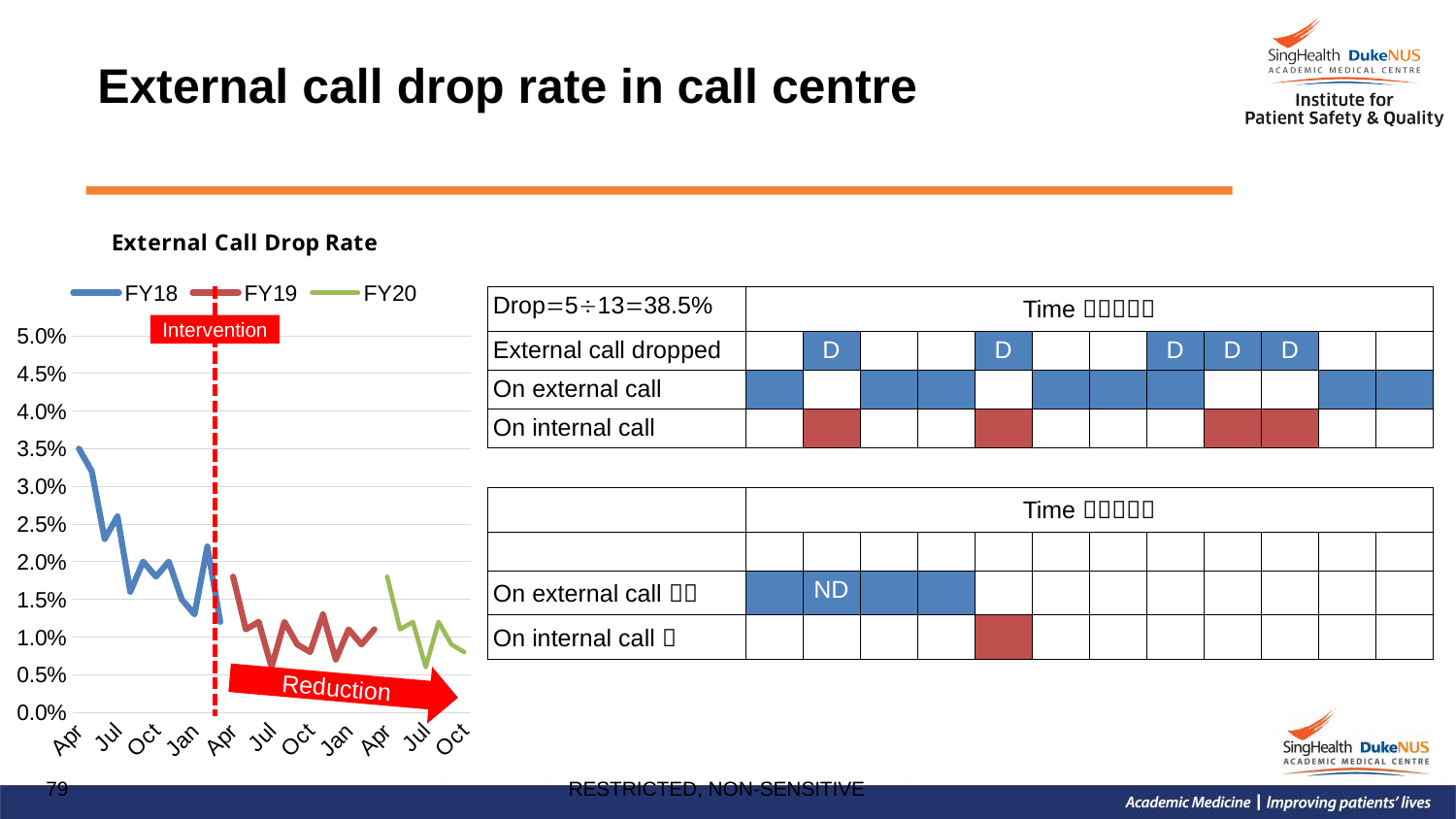
Is the FY20 value at Oct greater or less than 1.0%? less Does the FY18 line rise or fall from Apr to the end of the fiscal year? Fall What is the title of the chart on the slide? External Call Drop Rate Are the FY19 values greater or less than 2.0%? less Is the FY18 value at Apr greater or less than 4.0%? less What is the highest value shown on the vertical axis of the chart? 5.0% Which series reaches the highest external call drop rate on the chart? FY18 Which series are listed in the legend of the External Call Drop Rate chart? FY18, FY19, FY20 How many series does the legend of the External Call Drop Rate chart list? 3 Which is larger, the FY18 value at Apr or the FY20 value at Apr? FY18 value at Apr What kind of chart is shown on the slide? Line chart